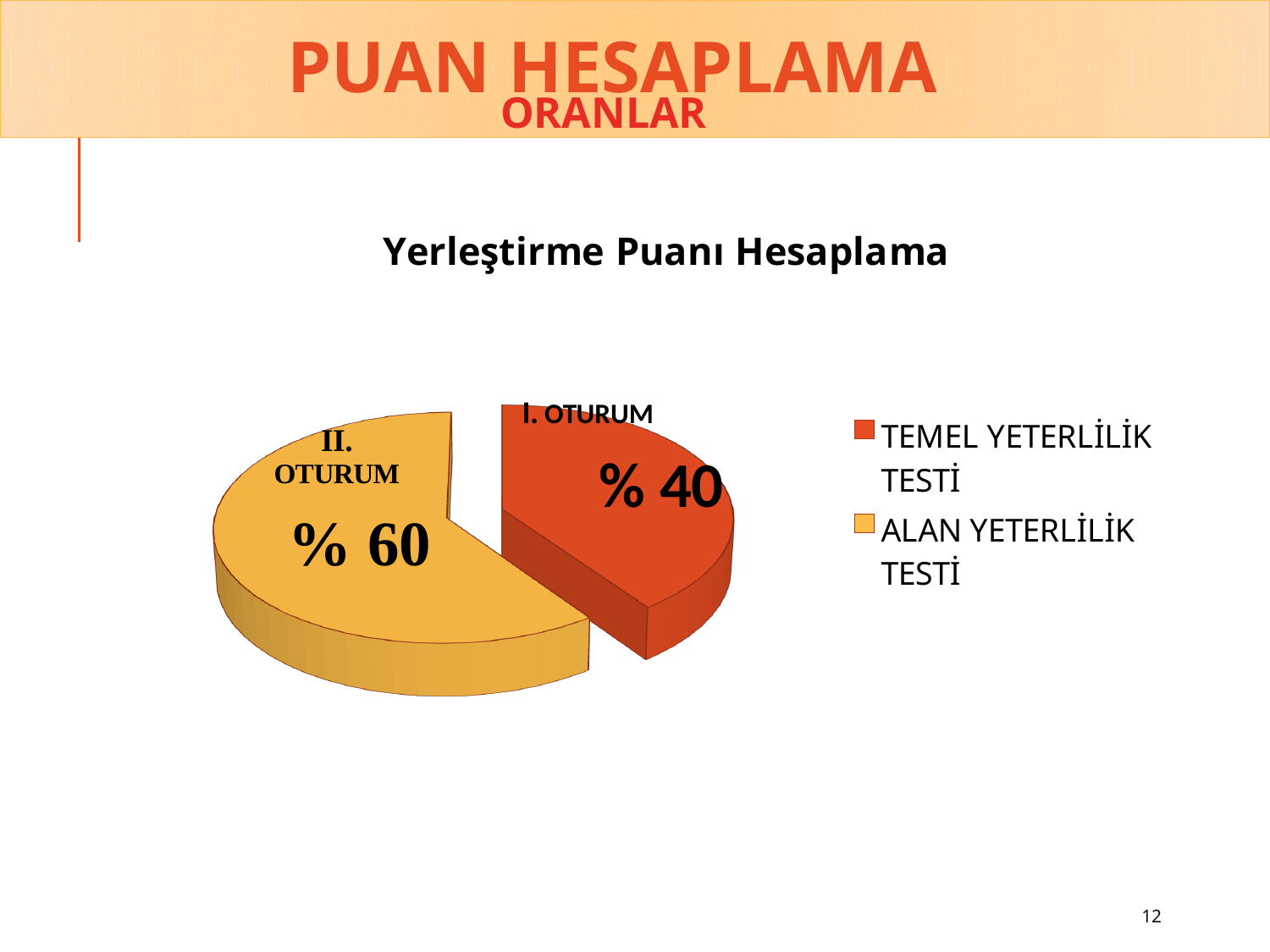
What is the title of the chart? Yerleştirme Puanı Hesaplama Which legend entry is shown in orange-red? TEMEL YETERLİLİK TESTİ What kind of chart is shown on the slide? pie chart Which slice is the largest? II. OTURUM What is the value shown for the I. OTURUM slice? % 40 What is the value shown for the II. OTURUM slice? % 60 What share of the pie does the I. OTURUM slice represent? % 40 How many slices does the pie chart have? 2 Which slice is the smallest? I. OTURUM What is the difference between the II. OTURUM and I. OTURUM values? 20 How many entries does the legend list? 2 Which is larger, the I. OTURUM slice or the II. OTURUM slice? II. OTURUM